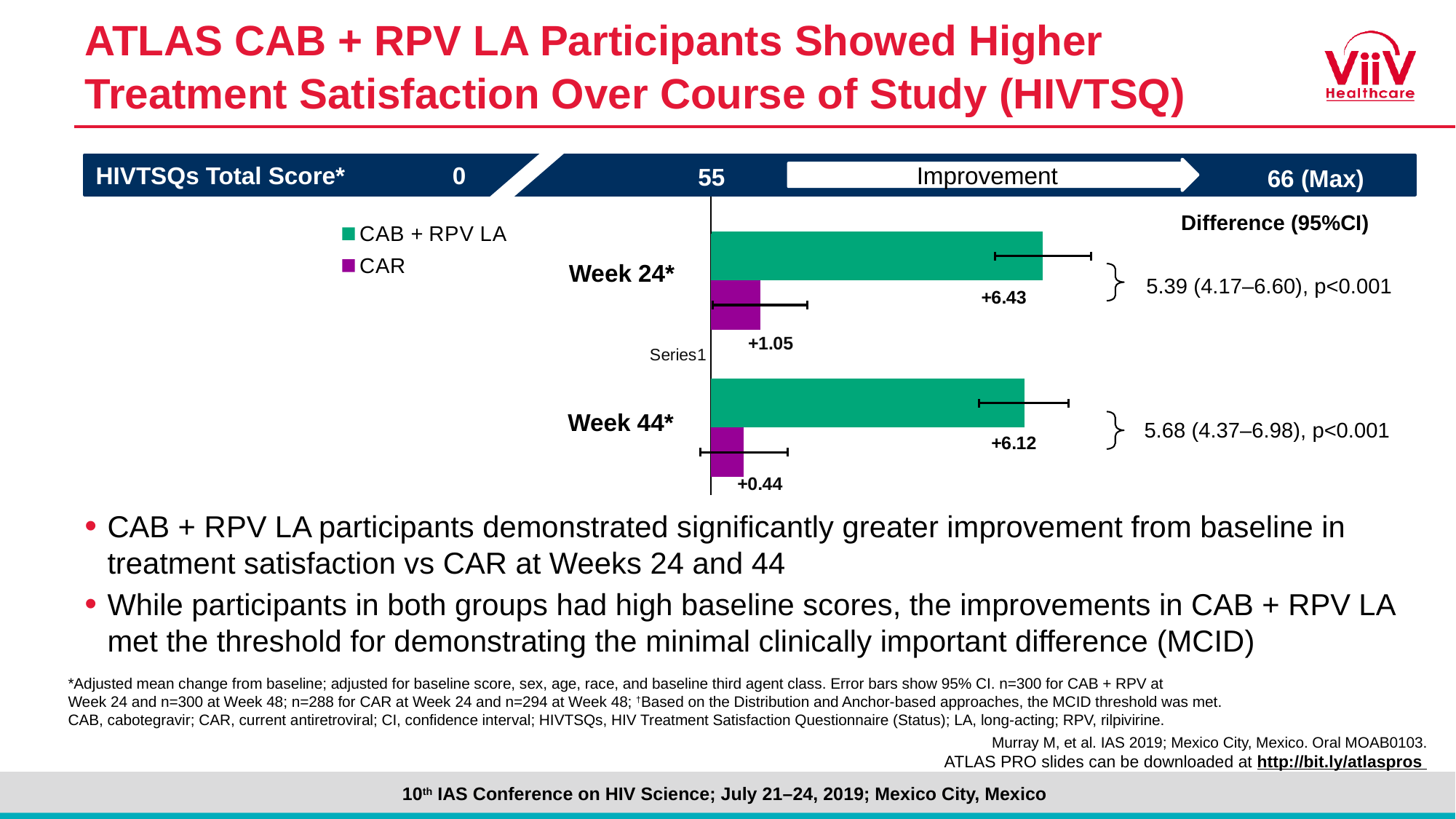
What is the value for CAB + RPV LA at Week 44*? +6.12 Which series has the higher value at Week 44*, CAB + RPV LA or CAR? CAB + RPV LA Which bar has the highest value on the chart? CAB + RPV LA at Week 24* What is the Difference (95%CI) shown for Week 44*? 5.68 (4.37–6.98), p<0.001 What is the value for CAR at Week 44*? +0.44 What kind of chart is shown on the slide? Bar chart Which bar has the lowest value on the chart? CAR at Week 44* How many series does the legend list? 2 What is the difference between the CAB + RPV LA value and the CAR value at Week 24*? 5.38 What is the value for CAB + RPV LA at Week 24*? +6.43 What colour are the CAR bars in the chart? Purple What is the value for CAR at Week 24*? +1.05